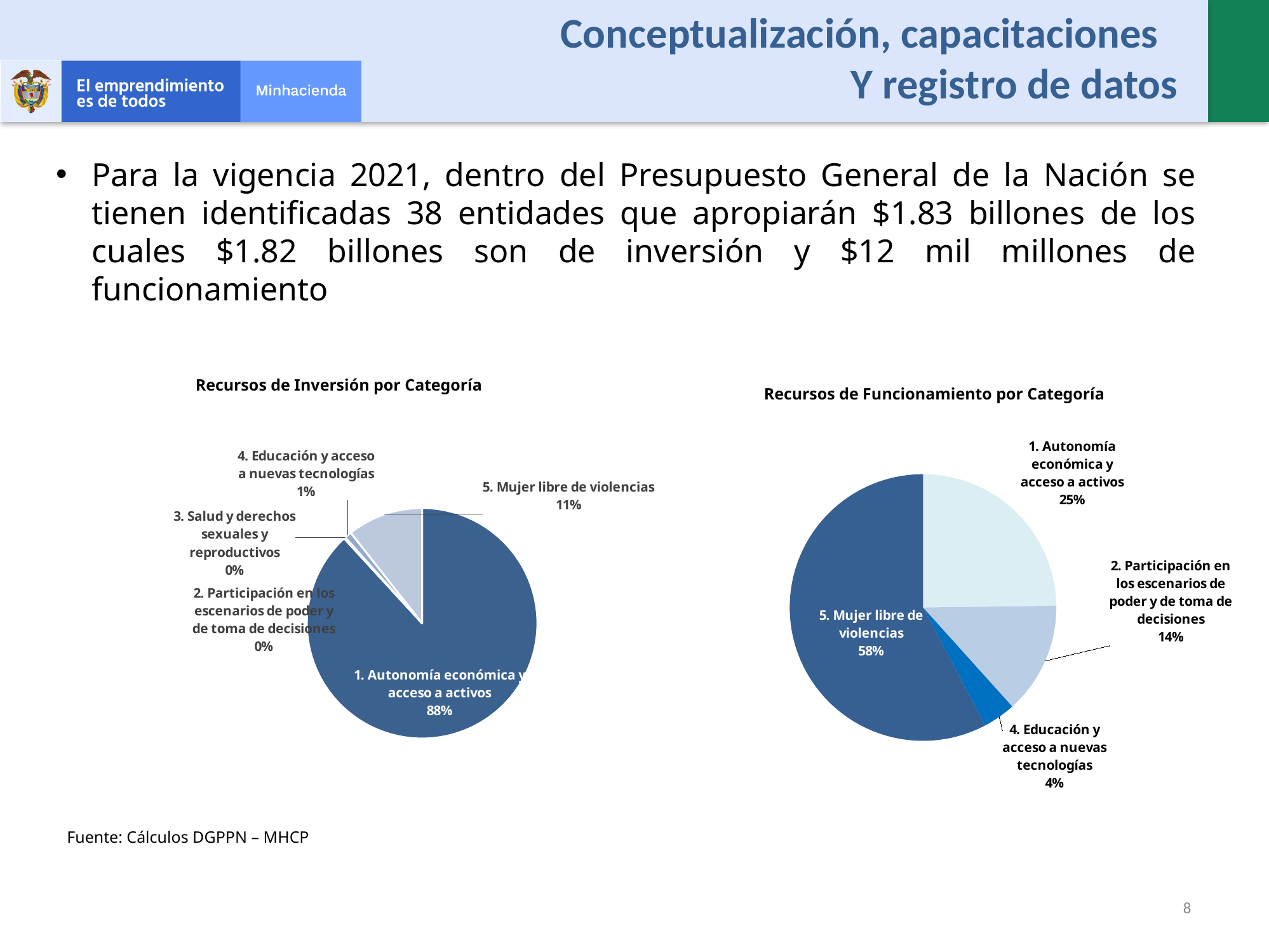
What type of chart is 'Recursos de Inversión por Categoría'? Pie chart In the 'Recursos de Inversión por Categoría' chart, what share does '5. Mujer libre de violencias' have? 11% In the 'Recursos de Inversión por Categoría' chart, which category has the largest share? 1. Autonomía económica y acceso a activos In the 'Recursos de Funcionamiento por Categoría' chart, which category has the largest share? 5. Mujer libre de violencias In the 'Recursos de Funcionamiento por Categoría' chart, what share does '4. Educación y acceso a nuevas tecnologías' have? 4% How many slices are labelled in the 'Recursos de Funcionamiento por Categoría' chart? 4 In the 'Recursos de Funcionamiento por Categoría' chart, what share does '2. Participación en los escenarios de poder y de toma de decisiones' have? 14% In the 'Recursos de Funcionamiento por Categoría' chart, which category has the smallest share? 4. Educación y acceso a nuevas tecnologías In the 'Recursos de Funcionamiento por Categoría' chart, what is the difference in percentage points between '1. Autonomía económica y acceso a activos' and '2. Participación en los escenarios de poder y de toma de decisiones'? 11 percentage points